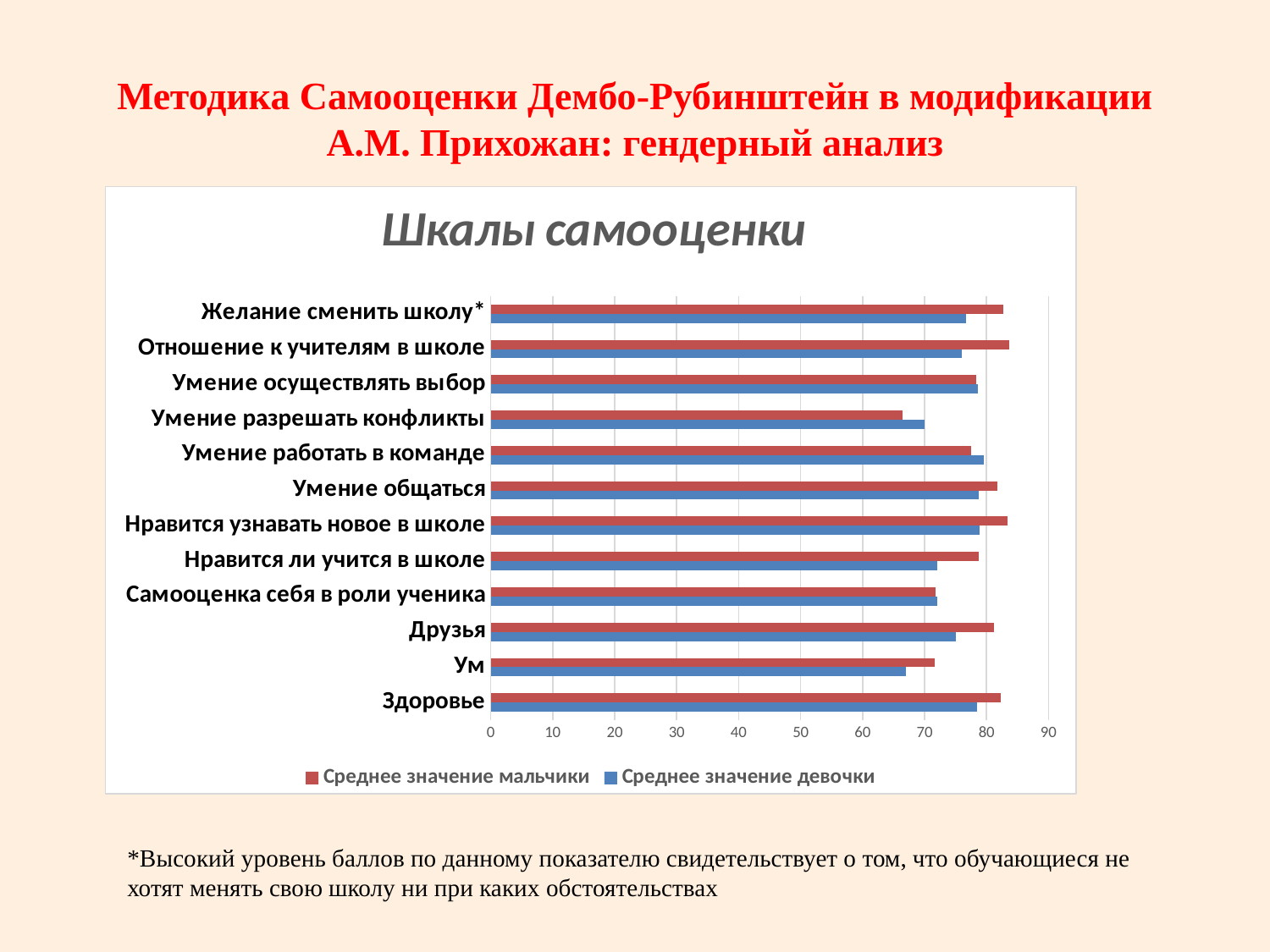
For Отношение к учителям в школе, which series has the larger value: Среднее значение мальчики or Среднее значение девочки? Среднее значение мальчики What is the title of the chart? Шкалы самооценки Is the value for Отношение к учителям в школе in the series Среднее значение мальчики greater or less than 80? greater Which category has the lowest value for Среднее значение мальчики? Умение разрешать конфликты How many series does the chart legend list? 2 Which series is shown in red? Среднее значение мальчики Is the value for Ум in the series Среднее значение девочки greater or less than 70? less For Умение разрешать конфликты, which series has the larger value: Среднее значение мальчики or Среднее значение девочки? Среднее значение девочки Is the value for Умение разрешать конфликты in the series Среднее значение мальчики greater or less than 70? less Which category has the lowest value for Среднее значение девочки? Ум How many categories are plotted on the chart? 12 What kind of chart is shown on the slide? bar chart